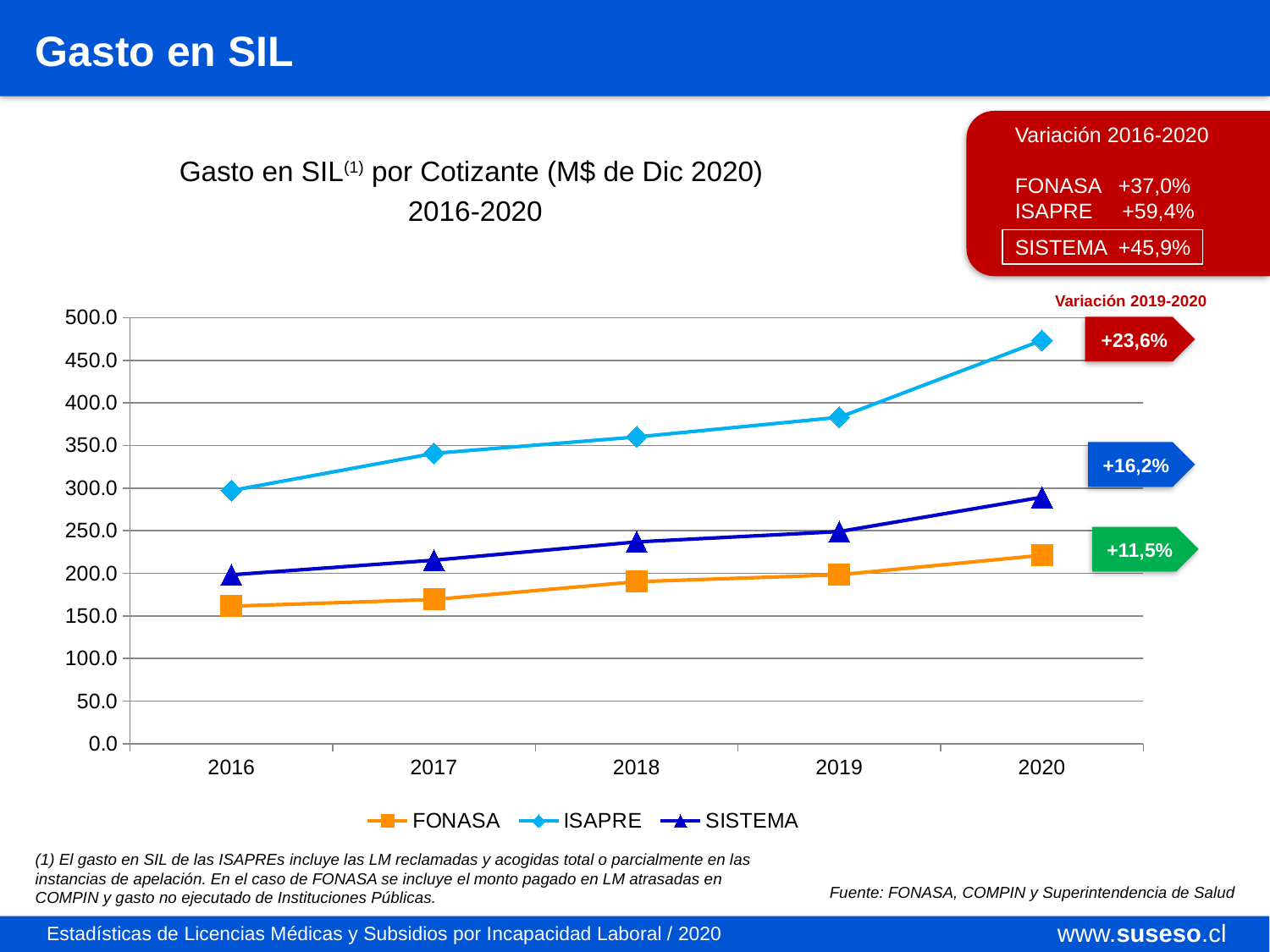
Do the values for ISAPRE rise or fall from 2016 to 2020? rise Is the value for SISTEMA in 2020 greater or less than 300? less Is the value for ISAPRE in 2019 greater or less than 400? less Which is larger in 2018, the value for SISTEMA or the value for FONASA? SISTEMA Is the value for FONASA in 2020 greater or less than 200? greater How many years are plotted along the x axis of the chart? 5 Which series has the lowest value in 2016? FONASA Which series is drawn in orange in the chart? FONASA How many series does the chart legend list? 3 Which series has the highest value in 2020? ISAPRE What kind of chart is shown on the slide? line chart